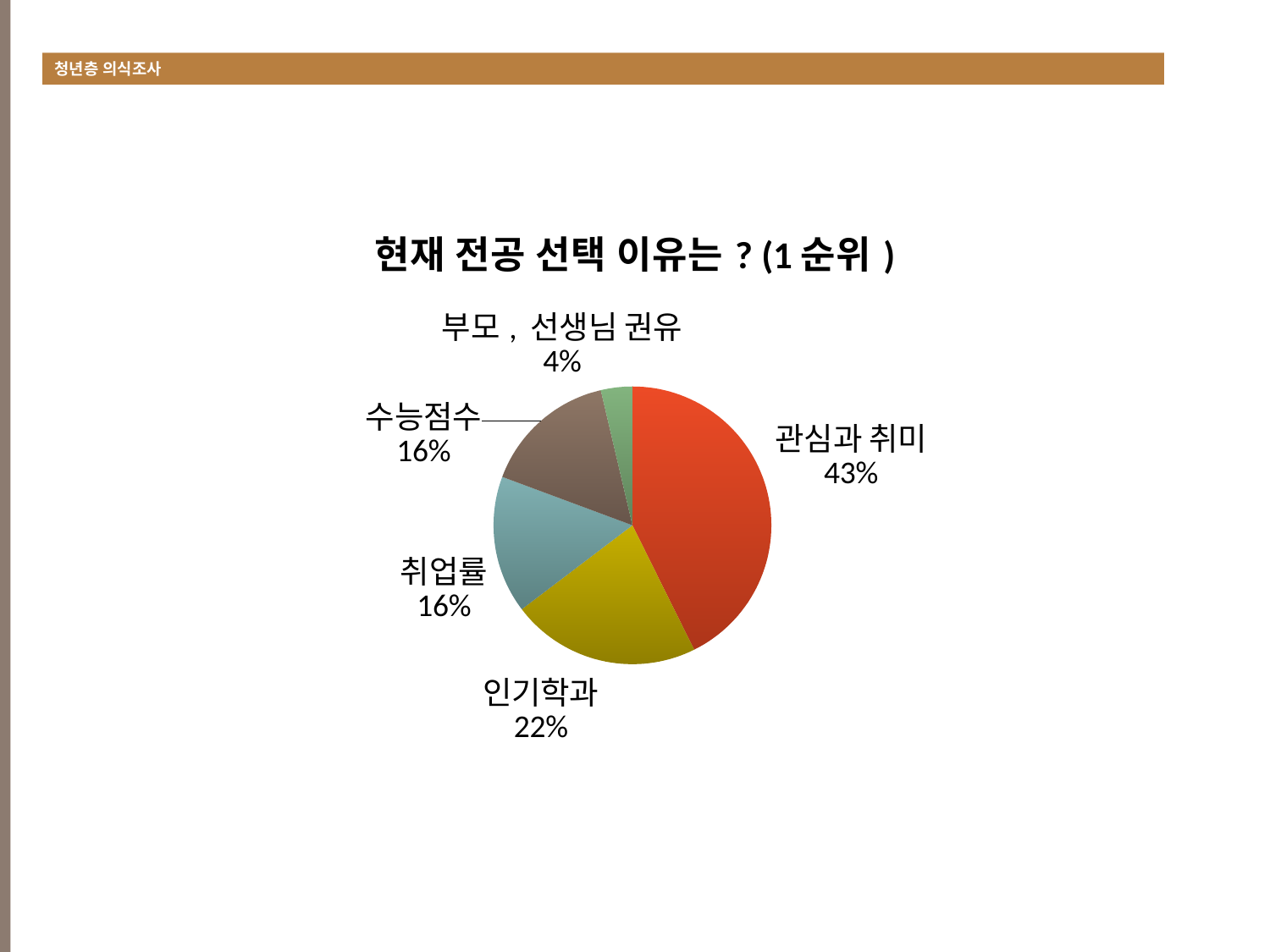
What percentage is shown for 부모 , 선생님 권유? 4% What percentage is shown for 관심과 취미? 43% Which is larger, the share for 인기학과 or the share for 취업률? 인기학과 How many slices does the pie chart have? 5 What kind of chart is shown on the slide? pie chart What percentage is shown for 인기학과? 22% Which category has the smallest share of the pie? 부모 , 선생님 권유 What is the title of the chart? 현재 전공 선택 이유는 ? (1 순위 ) What percentage is shown for 수능점수? 16% What colour is the slice for 관심과 취미? red Which category has the largest share of the pie? 관심과 취미 What is the difference in percentage points between 관심과 취미 and 인기학과? 21